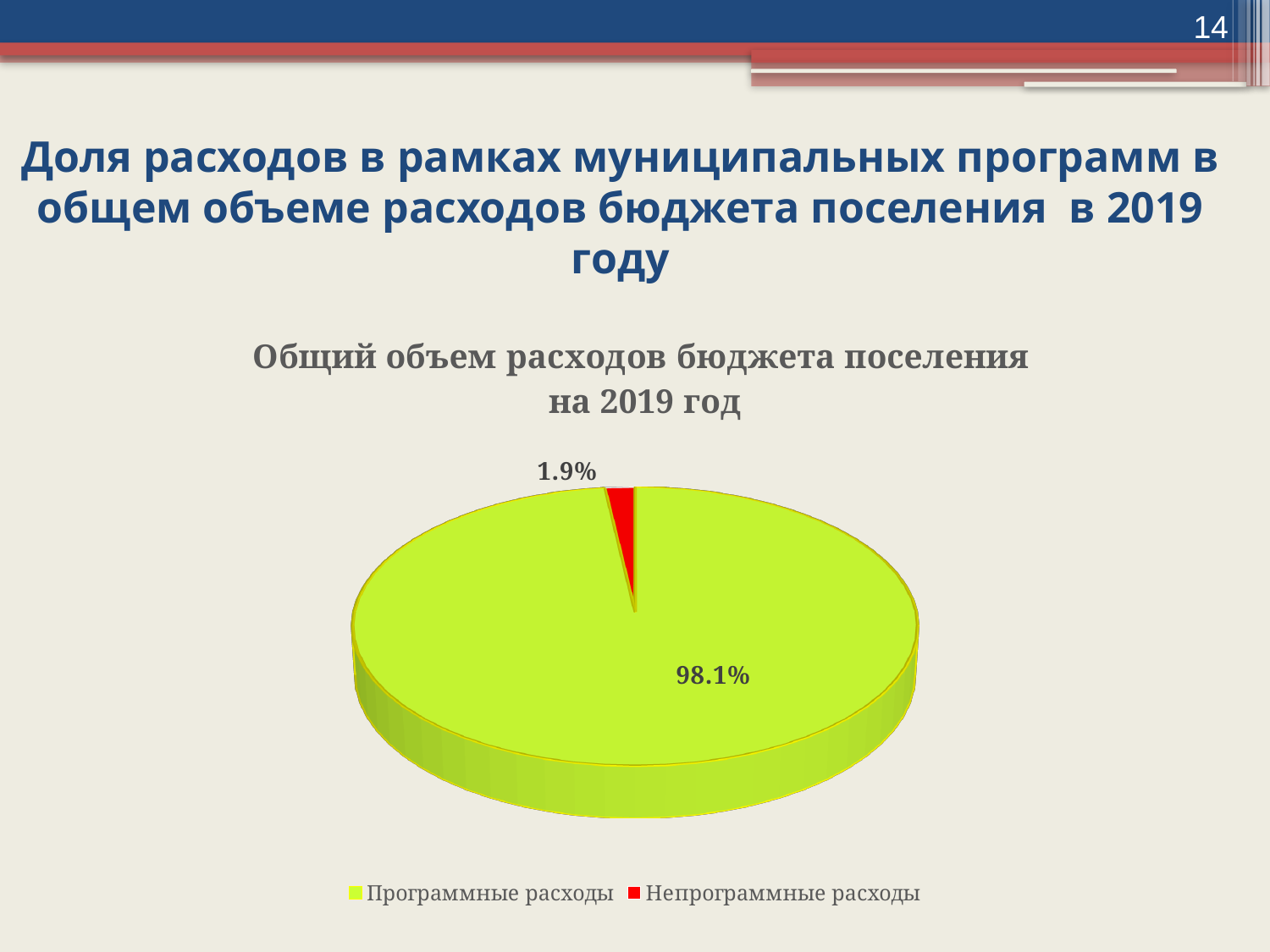
How many slices does the pie chart have? 2 What kind of chart is shown on the slide? pie chart Which category has the smallest slice of the pie? Непрограммные расходы What share of the pie is Программные расходы? 98.1% Which category has the largest slice of the pie? Программные расходы How many entries does the legend list? 2 What is the title of the chart? Общий объем расходов бюджета поселения на 2019 год What colour is the slice for Непрограммные расходы? red What share of the pie is Непрограммные расходы? 1.9% Which is larger, Программные расходы or Непрограммные расходы? Программные расходы What is the difference in percentage points between Программные расходы and Непрограммные расходы? 96.2